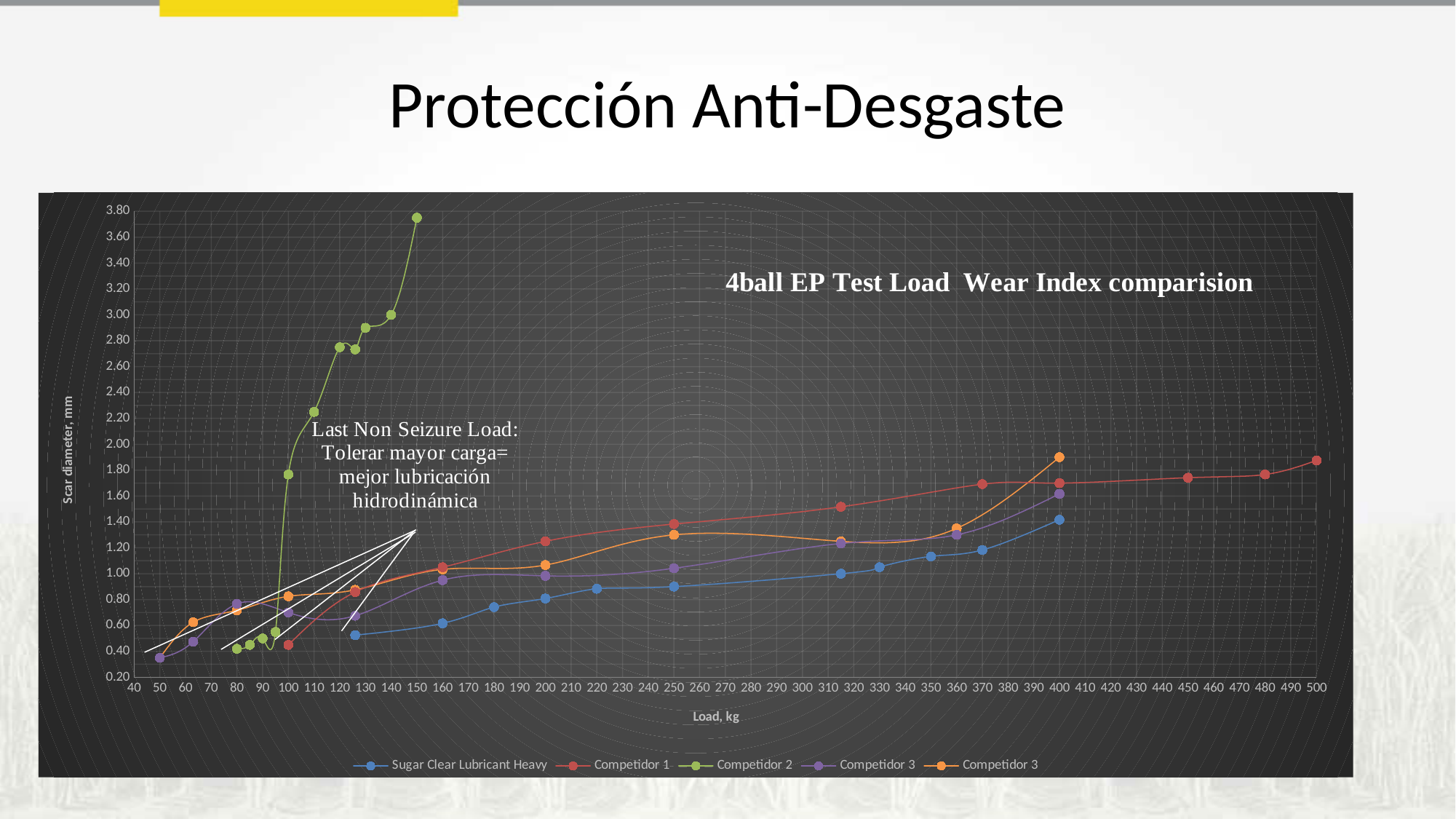
Which series reaches the highest scar diameter on the chart? Competidor 2 Does the scar diameter for Sugar Clear Lubricant Heavy generally rise or fall as load increases? rise Is the value for Competidor 2 at 150 kg greater or less than 3.00? greater What is the title of the chart? 4ball EP Test Load Wear Index comparision Is the value for Sugar Clear Lubricant Heavy at 400 kg greater or less than 1.60? less Is the value for Sugar Clear Lubricant Heavy at 250 kg greater or less than 1.00? less Which series extends to the highest load of 500 kg on the chart? Competidor 1 At 400 kg, which has the larger scar diameter: Sugar Clear Lubricant Heavy or Competidor 1? Competidor 1 What is the label of the x axis of the chart? Load, kg What kind of chart is shown on the slide? line chart How many series does the chart legend list? 5